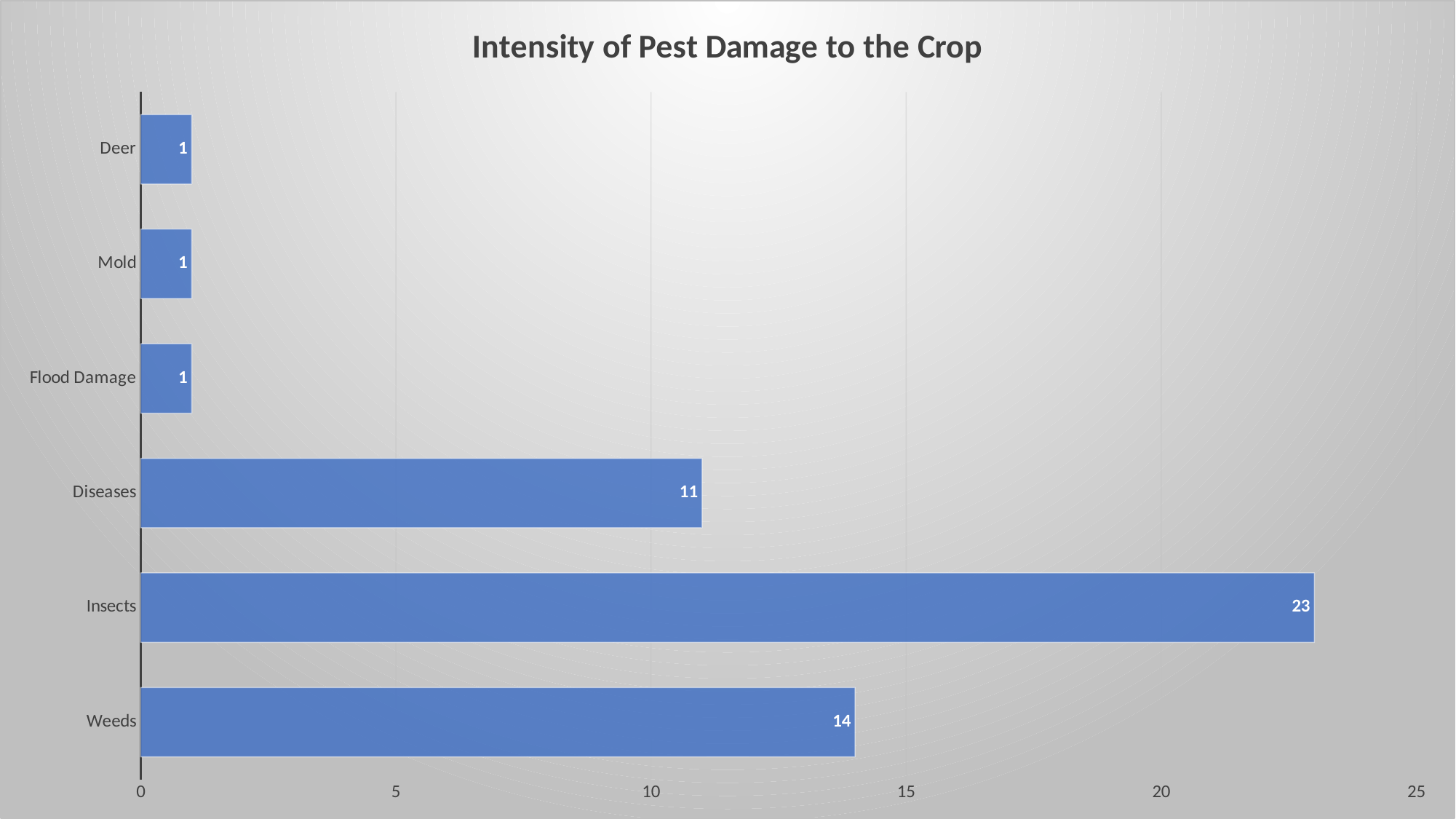
What is the title of the chart? Intensity of Pest Damage to the Crop Is the value for Insects greater or less than 20? greater How many categories are shown on the chart? 6 What is the value for Flood Damage? 1 Which is larger, the value for Diseases or the value for Weeds? Weeds What is the value for Weeds? 14 What is the value for Diseases? 11 What kind of chart is shown on the slide? Bar chart What is the difference between the values for Insects and Weeds? 9 What is the value for Insects? 23 What is the difference between the values for Weeds and Diseases? 3 Which category has the highest value? Insects